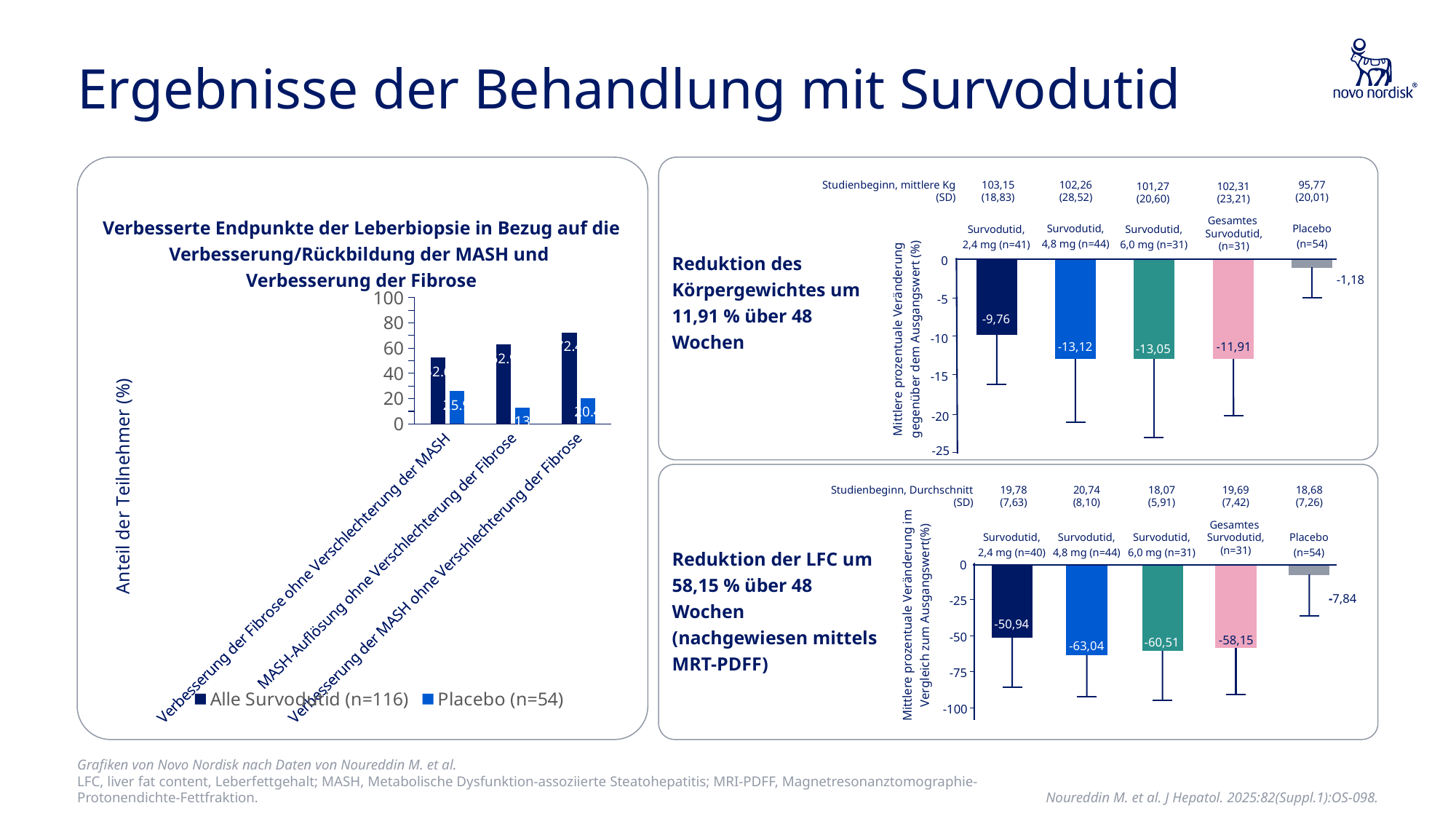
In the chart 'Reduktion des Körpergewichtes um 11,91 % über 48 Wochen', what is the difference between the values for Gesamtes Survodutid (n=31) and Placebo (n=54)? 10,73 In the chart 'Reduktion der LFC um 58,15 % über 48 Wochen', what is the value for Survodutid, 6,0 mg (n=31)? -60,51 In the chart 'Reduktion des Körpergewichtes um 11,91 % über 48 Wochen', what is the value for Placebo (n=54)? -1,18 What kind of chart is 'Reduktion der LFC um 58,15 % über 48 Wochen'? bar chart In the left chart 'Verbesserte Endpunkte der Leberbiopsie...', how many series does the legend list? 2 In the chart 'Reduktion der LFC um 58,15 % über 48 Wochen', which group shows the largest reduction (lowest value)? Survodutid, 4,8 mg (n=44) In the chart 'Reduktion des Körpergewichtes um 11,91 % über 48 Wochen', how many bars are plotted? 5 In the chart 'Reduktion des Körpergewichtes um 11,91 % über 48 Wochen', what is the value for Survodutid, 4,8 mg (n=44)? -13,12 In the chart 'Reduktion der LFC um 58,15 % über 48 Wochen', which group shows the smallest reduction (highest value)? Placebo (n=54) In the left chart 'Verbesserte Endpunkte der Leberbiopsie...', is the value for Alle Survodutid (n=116) in 'Verbesserung der MASH ohne Verschlechterung der Fibrose' greater or less than 60? greater In the chart 'Reduktion der LFC um 58,15 % über 48 Wochen', what is the value for Gesamtes Survodutid (n=31)? -58,15 In the chart 'Reduktion der LFC um 58,15 % über 48 Wochen', which shows a larger reduction: Survodutid, 2,4 mg or Survodutid, 6,0 mg? Survodutid, 6,0 mg